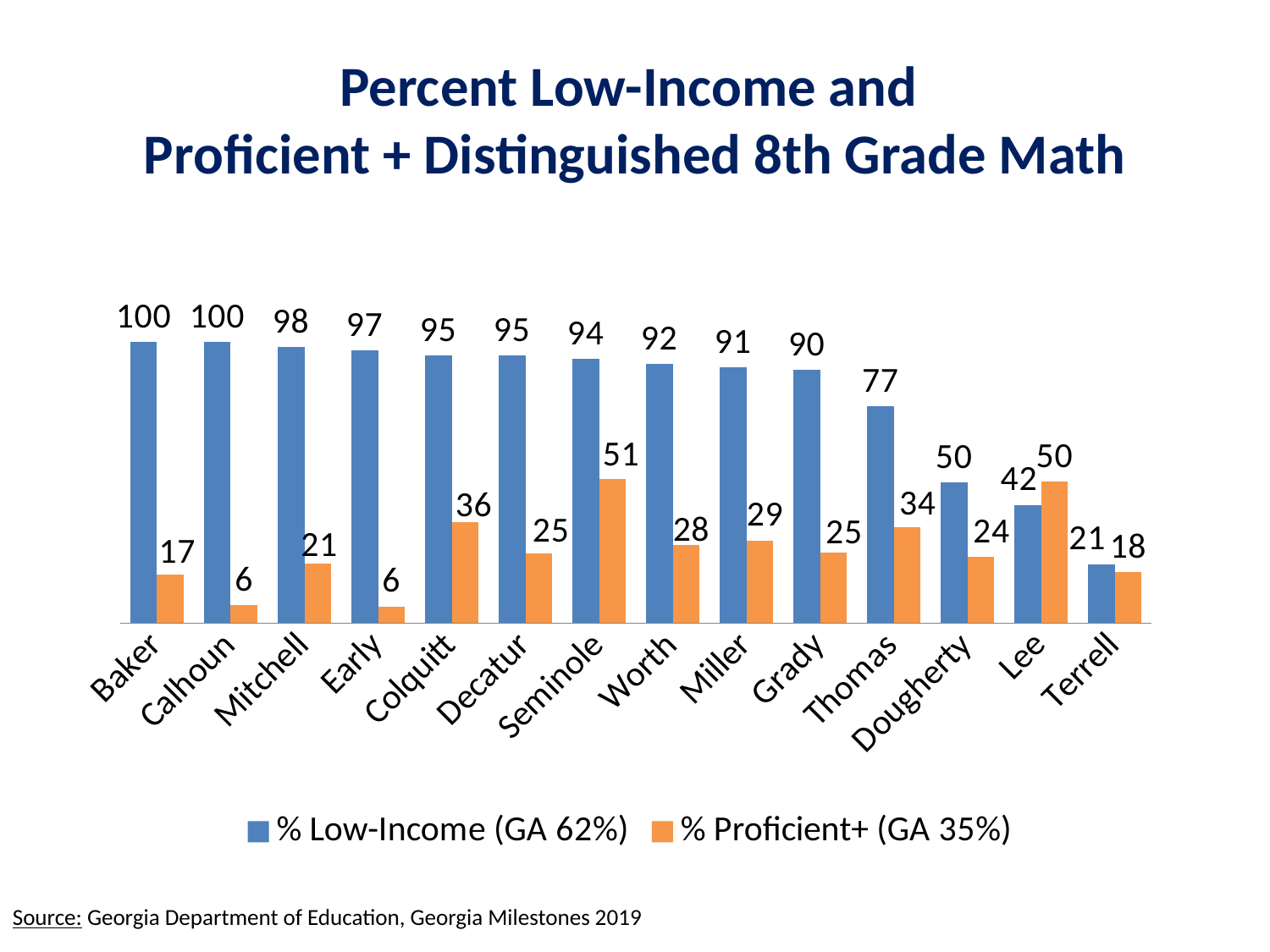
What is the title of the chart? Percent Low-Income and Proficient + Distinguished 8th Grade Math What is the % Proficient+ value for Lee? 50 Which county has the highest % Proficient+ value? Seminole How many counties are shown on the x axis? 14 How many series does the legend list? 2 Which is larger for Lee: the % Low-Income value or the % Proficient+ value? % Proficient+ What is the difference between the % Low-Income and % Proficient+ values for Thomas? 43 Do the % Low-Income values rise or fall from Baker to Terrell along the x axis? Fall Which county has the lowest % Low-Income value? Terrell What is the % Low-Income value for Seminole? 94 What kind of chart is shown on the slide? Bar chart What is the % Proficient+ value for Colquitt? 36